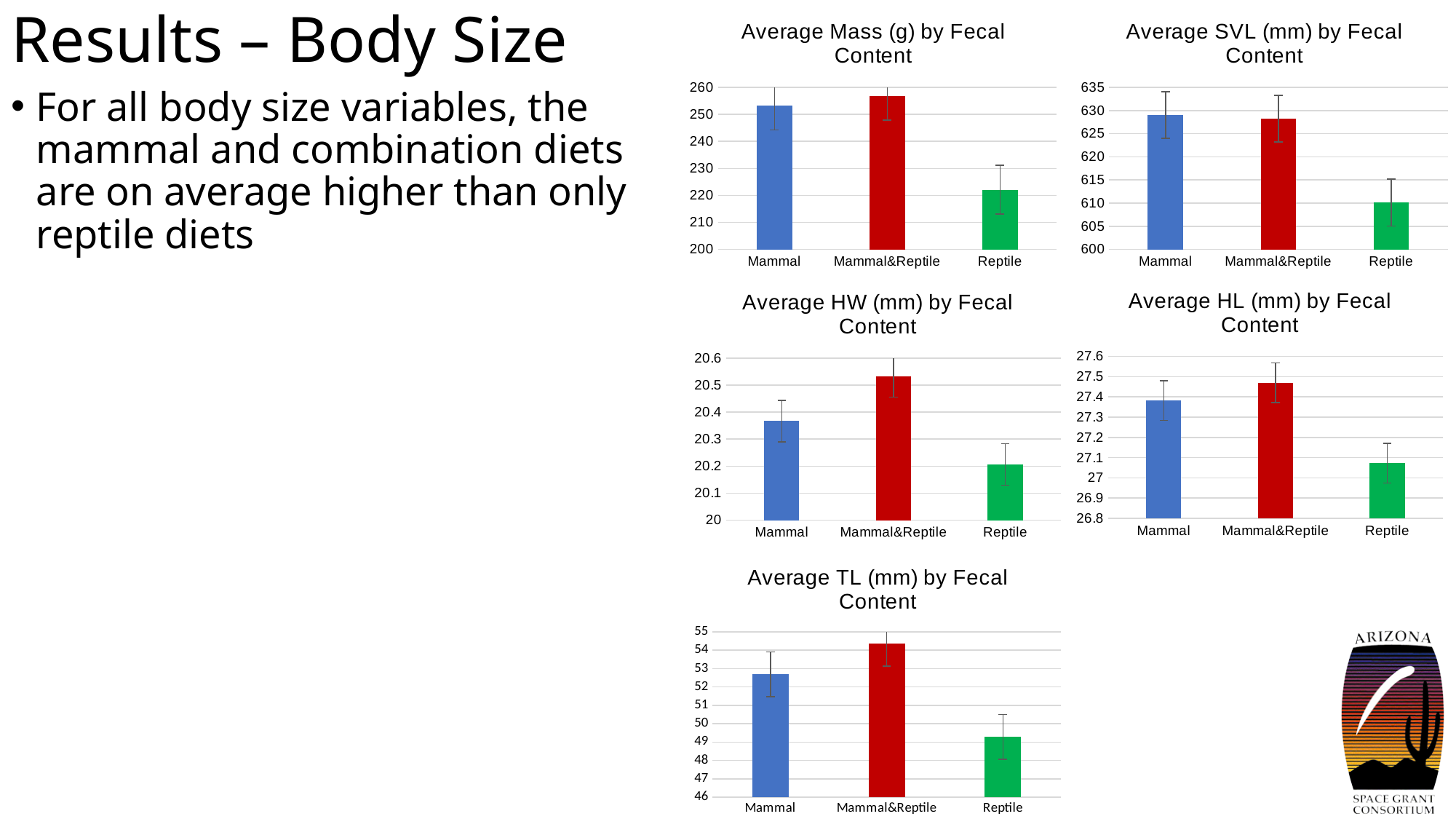
In the 'Average TL (mm) by Fecal Content' chart, which category has the highest value? Mammal&Reptile In the 'Average HW (mm) by Fecal Content' chart, is the value for Mammal&Reptile greater or less than 20.4? greater In the 'Average Mass (g) by Fecal Content' chart, is the value for Reptile greater or less than 230? less In the 'Average HL (mm) by Fecal Content' chart, is the value for Reptile greater or less than 27.2? less In the 'Average SVL (mm) by Fecal Content' chart, which category has the lowest value? Reptile In the 'Average HW (mm) by Fecal Content' chart, which category has the highest value? Mammal&Reptile In the 'Average Mass (g) by Fecal Content' chart, which category has the lowest value? Reptile What type of chart is the 'Average Mass (g) by Fecal Content' chart? bar chart In the 'Average HL (mm) by Fecal Content' chart, which is larger, the value for Mammal or the value for Reptile? Mammal How many categories are shown on the x axis of the 'Average TL (mm) by Fecal Content' chart? 3